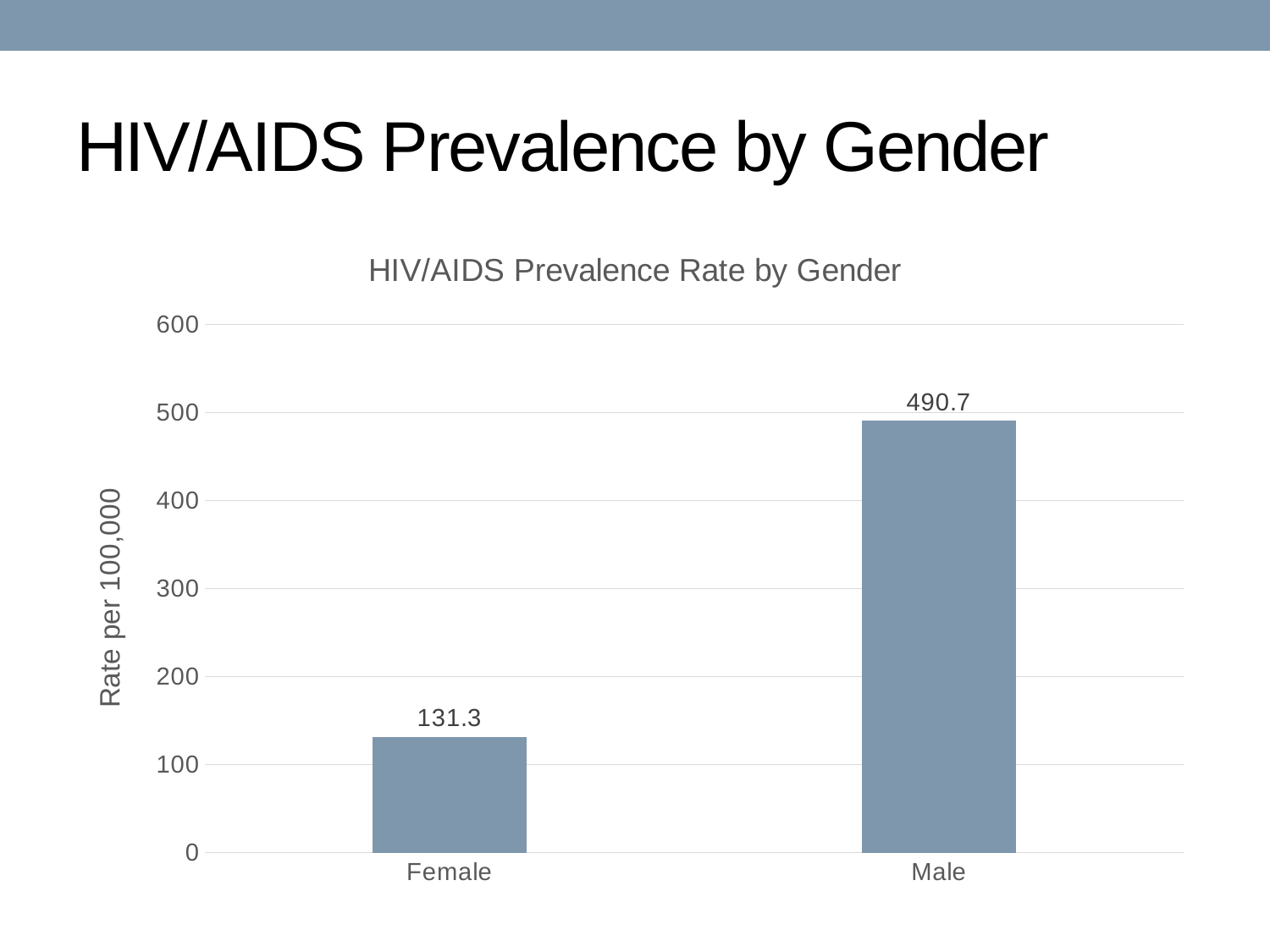
What is the label of the y axis? Rate per 100,000 Which is larger, the Female rate or the Male rate? Male What is the title of the chart? HIV/AIDS Prevalence Rate by Gender What kind of chart is shown on the slide? bar chart Is the prevalence rate for Male greater or less than 400? greater Which gender has the highest HIV/AIDS prevalence rate? Male How many categories are shown on the x axis? 2 What is the HIV/AIDS prevalence rate for Female? 131.3 Which gender has the lowest HIV/AIDS prevalence rate? Female What is the HIV/AIDS prevalence rate for Male? 490.7 What is the difference between the Male and Female prevalence rates? 359.4 Is the prevalence rate for Female greater or less than 200? less